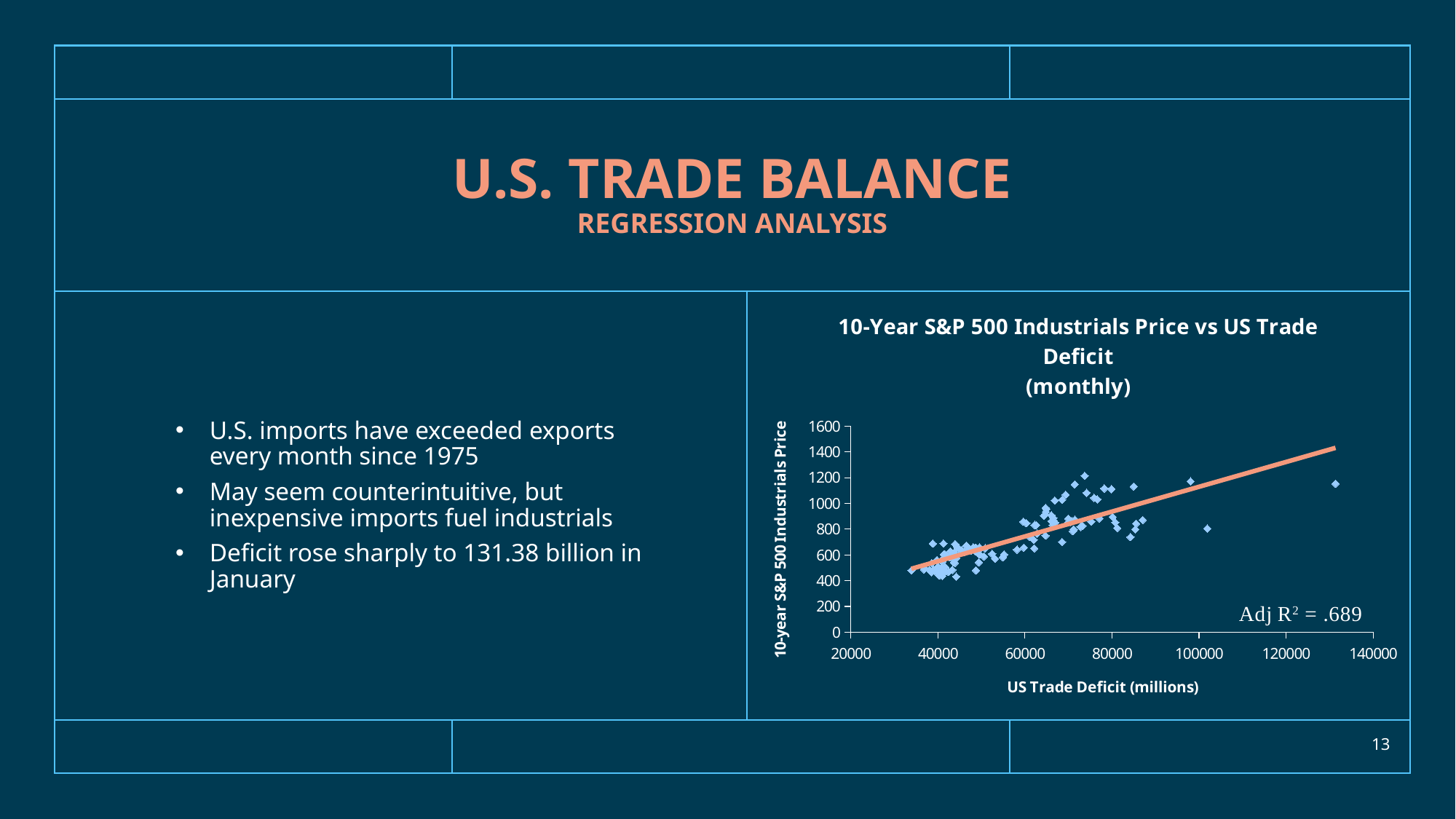
What is the lowest value shown on the x axis of the chart? 20000 Is the 10-year S&P 500 Industrials Price for the rightmost point (near a trade deficit of 130000) greater or less than 1000? greater Are the points clustered around a trade deficit of 40000 mostly greater or less than 800 on the y axis? less What is the label of the x axis of the chart? US Trade Deficit (millions) What is the highest value shown on the y axis of the chart? 1600 Does the trend line on the chart slope upward or downward from left to right? Upward What is the title of the chart? 10-Year S&P 500 Industrials Price vs US Trade Deficit (monthly) Do the plotted values generally rise or fall as the US trade deficit increases along the x axis? Rise What adjusted R-squared value is printed on the chart? .689 What kind of chart is shown on the slide? Scatter chart